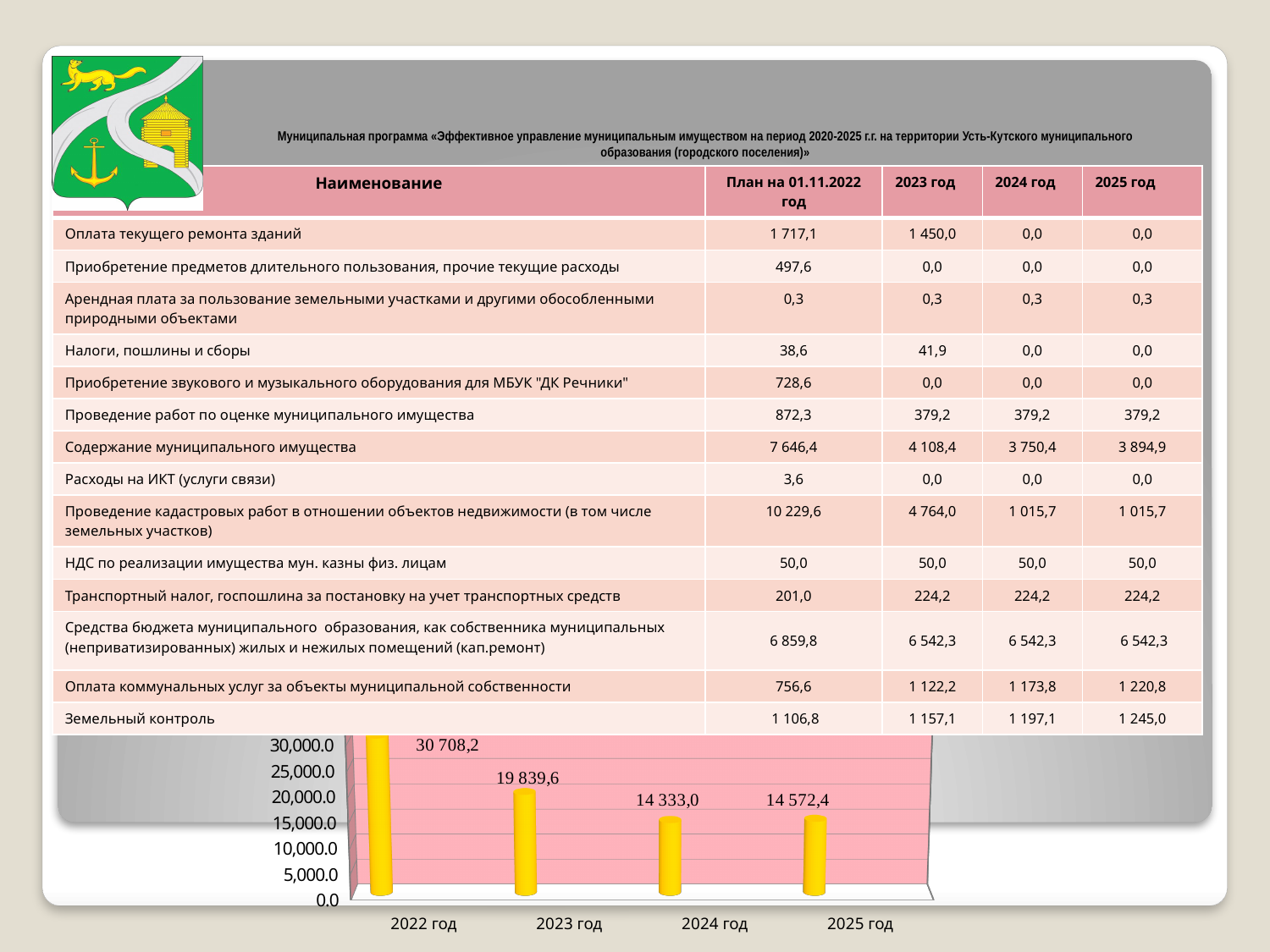
Which year has the highest value in the bar chart? 2022 год Is the value for 2022 год in the bar chart greater or less than 25,000.0? greater What is the value shown for 2022 год in the bar chart? 30 708,2 What is the value shown for 2023 год in the bar chart? 19 839,6 Which year has the lowest value in the bar chart? 2024 год What is the difference between the values for 2025 год and 2024 год in the bar chart? 239,4 How many years are plotted in the bar chart? 4 What is the value shown for 2025 год in the bar chart? 14 572,4 In the bar chart, which is larger: the value for 2023 год or the value for 2025 год? 2023 год What is the difference between the values for 2022 год and 2023 год in the bar chart? 10 868,6 What is the value shown for 2024 год in the bar chart? 14 333,0 What kind of chart is shown at the bottom of the slide? Bar chart